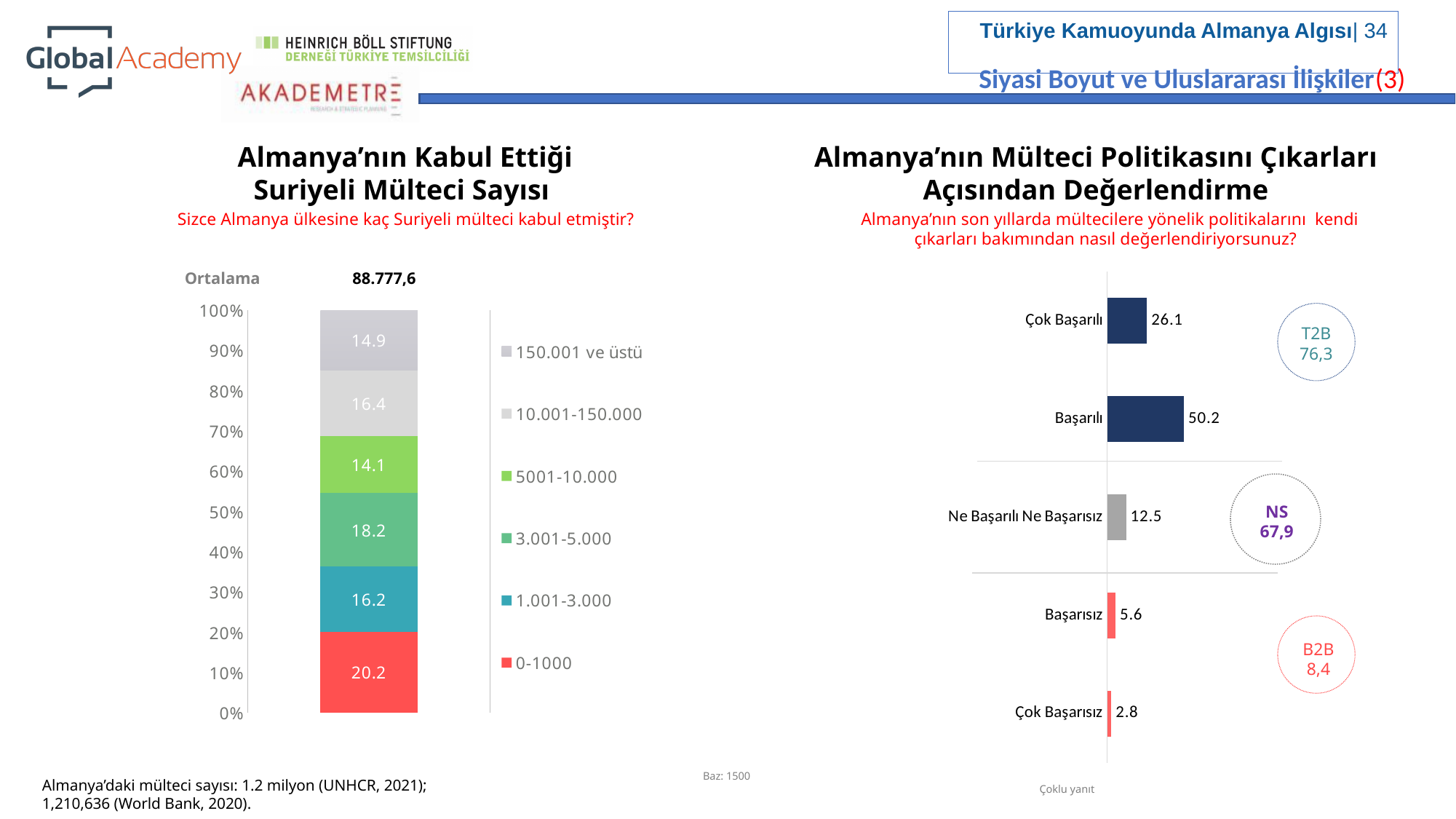
In the chart titled 'Almanya'nın Kabul Ettiği Suriyeli Mülteci Sayısı', which segment has the largest value? 0-1000 In the chart titled 'Almanya'nın Mülteci Politikasını Çıkarları Açısından Değerlendirme', what is the difference between 'Çok Başarılı' and 'Ne Başarılı Ne Başarısız'? 13.6 In the chart titled 'Almanya'nın Mülteci Politikasını Çıkarları Açısından Değerlendirme', which category has the highest value? Başarılı In the chart titled 'Almanya'nın Mülteci Politikasını Çıkarları Açısından Değerlendirme', how many categories are shown? 5 In the chart titled 'Almanya'nın Mülteci Politikasını Çıkarları Açısından Değerlendirme', what is the value for 'Çok Başarısız'? 2.8 In the chart titled 'Almanya'nın Kabul Ettiği Suriyeli Mülteci Sayısı', how many entries does the legend list? 6 In the chart titled 'Almanya'nın Mülteci Politikasını Çıkarları Açısından Değerlendirme', what is the value for 'Başarılı'? 50.2 In the chart titled 'Almanya'nın Kabul Ettiği Suriyeli Mülteci Sayısı', what is the value for the '0-1000' segment? 20.2 In the chart titled 'Almanya'nın Kabul Ettiği Suriyeli Mülteci Sayısı', what is the value for the '150.001 ve üstü' segment? 14.9 In the chart titled 'Almanya'nın Kabul Ettiği Suriyeli Mülteci Sayısı', which segment has the smallest value? 5001-10.000 What kind of chart is the one titled 'Almanya'nın Mülteci Politikasını Çıkarları Açısından Değerlendirme'? Bar chart In the chart titled 'Almanya'nın Kabul Ettiği Suriyeli Mülteci Sayısı', what is the difference between the '3.001-5.000' and '1.001-3.000' segments? 2.0